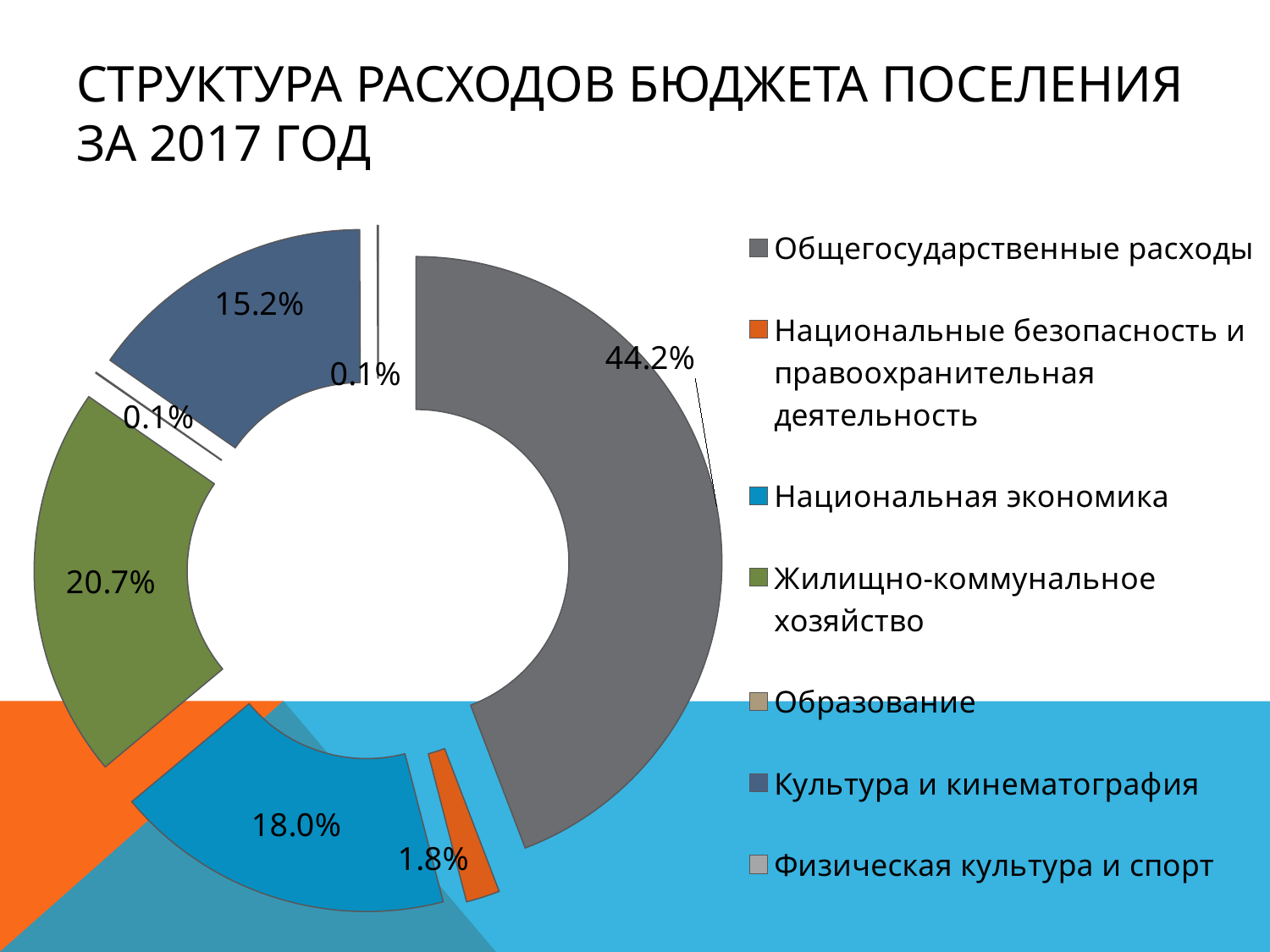
How many categories does the legend list? 7 What is the title of the chart slide? СТРУКТУРА РАСХОДОВ БЮДЖЕТА ПОСЕЛЕНИЯ ЗА 2017 ГОД What kind of chart is shown on the slide? doughnut chart What is the value for Национальные безопасность и правоохранительная деятельность? 1.8% What is the value for Жилищно-коммунальное хозяйство? 20.7% What share of the budget expenses goes to Общегосударственные расходы? 44.2% What is the value for Культура и кинематография? 15.2% Which category has the largest share of the budget expenses? Общегосударственные расходы What is the value for Национальная экономика? 18.0% What is the difference between the shares of Жилищно-коммунальное хозяйство and Национальная экономика? 2.7% What is the value for Образование? 0.1% Which is larger: the share for Культура и кинематография or the share for Национальная экономика? Национальная экономика